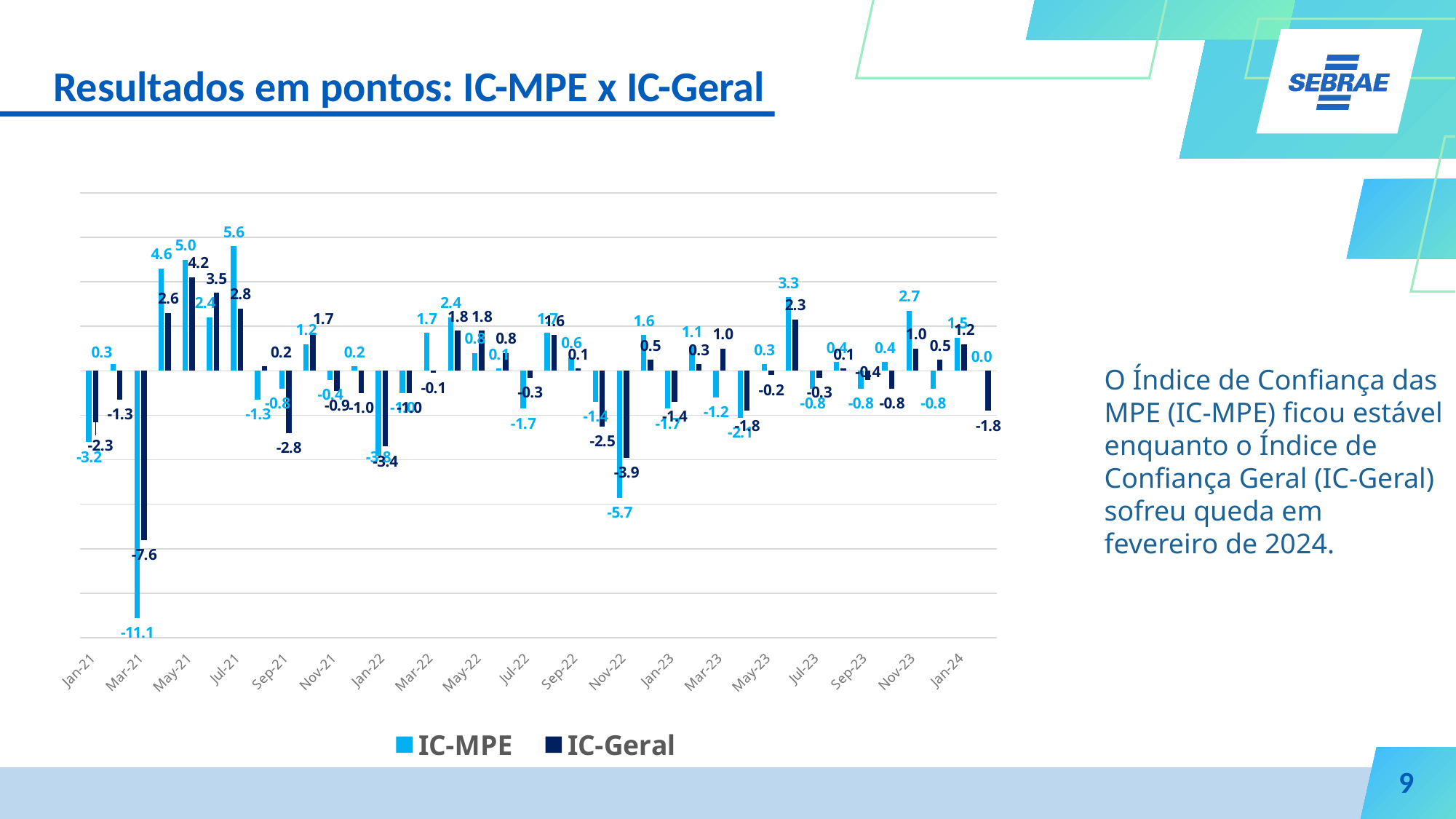
What is the IC-MPE value for Mar-21? -11.1 Which month has the highest IC-MPE value? Jul-21 How many series does the legend list? 2 Which month has the lowest IC-MPE value? Mar-21 What type of chart is shown on the slide? Bar chart What is the IC-Geral value for Mar-21? -7.6 What is the IC-MPE value for Jul-21? 5.6 Which month has the highest IC-Geral value? May-21 What is the difference between the IC-MPE and IC-Geral values in Jul-21? 2.8 What is the IC-Geral value for Jan-24? 1.2 In Jan-21, which series has the lower value, IC-MPE or IC-Geral? IC-MPE In Nov-23, which series has the larger value, IC-MPE or IC-Geral? IC-MPE